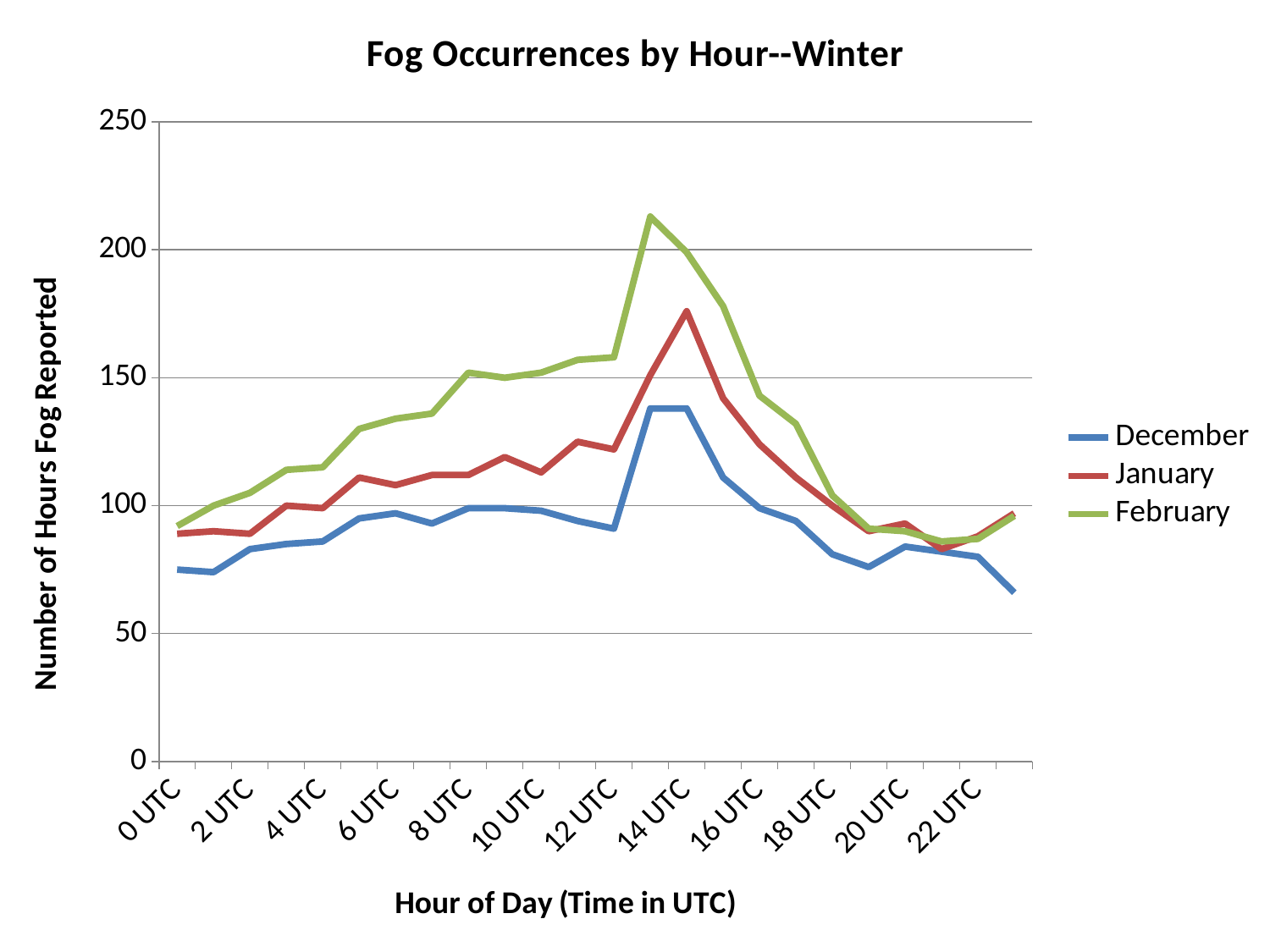
Does the February series generally rise or fall from 0 UTC to 13 UTC? rise How many series does the legend list? 3 At which hour does the February series reach its highest value? 13 UTC What is the label on the vertical axis? Number of Hours Fog Reported At which hour does the January series reach its highest value? 14 UTC At which hour does the December series reach its lowest value? 23 UTC Is the December value at 0 UTC greater or less than 100? less At 13 UTC, which series has the larger value, February or December? February Is the February value at 13 UTC greater or less than 200? greater What is the title of the chart? Fog Occurrences by Hour--Winter What kind of chart is shown on the slide? line chart